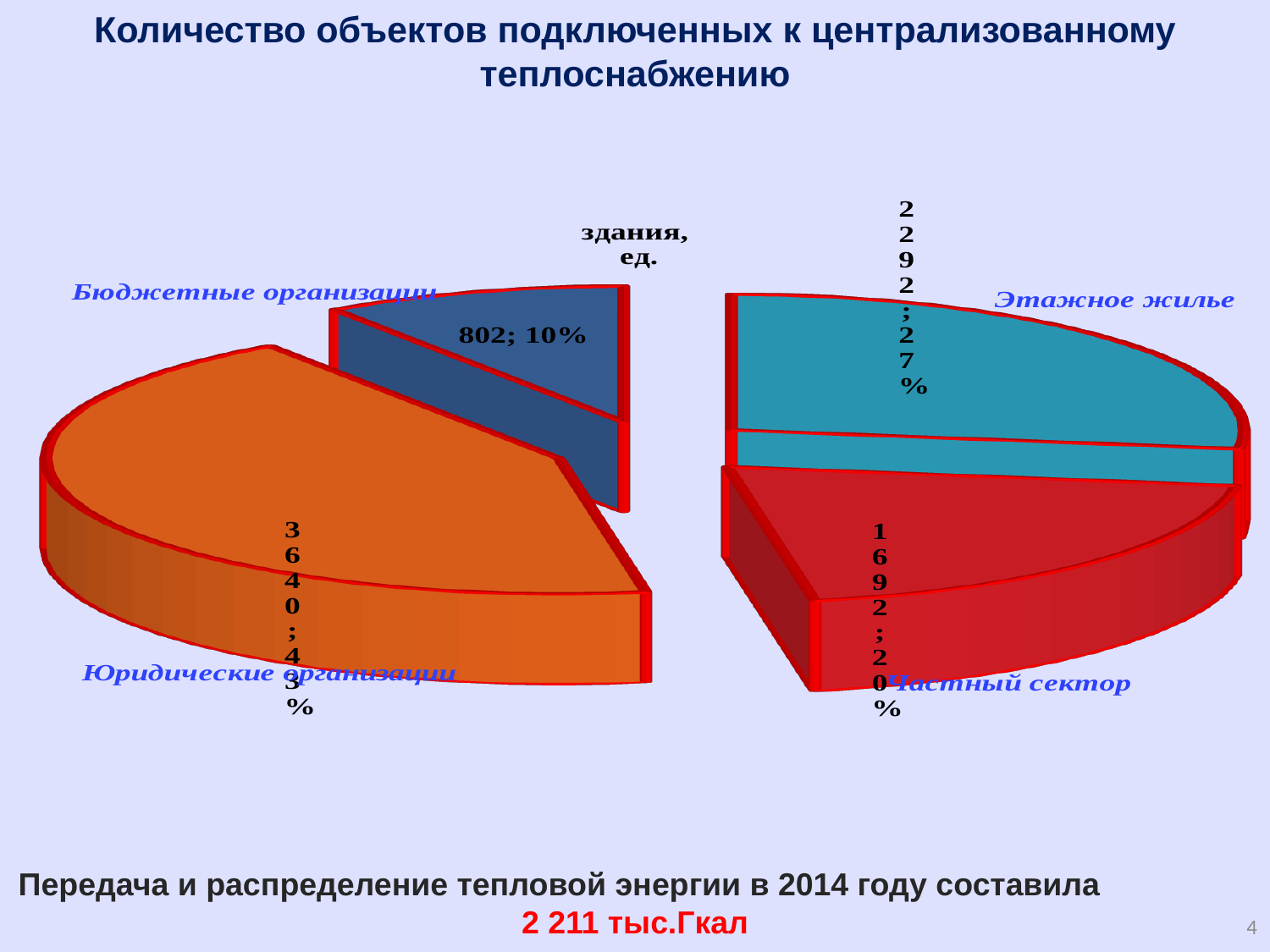
What is the value for Бюджетные организации? 802 What share of the pie does Юридические организации represent? 43% Which category has the largest slice? Юридические организации What is the difference between the values for Этажное жилье and Частный сектор? 600 What is the value for Этажное жилье? 2292 How many slices does the pie chart have? 4 What is the value for Юридические организации? 3640 What is the value for Частный сектор? 1692 Which category has the smallest slice? Бюджетные организации What kind of chart is shown on the slide? pie chart Which is larger, the value for Этажное жилье or the value for Частный сектор? Этажное жилье What share of the pie does Бюджетные организации represent? 10%